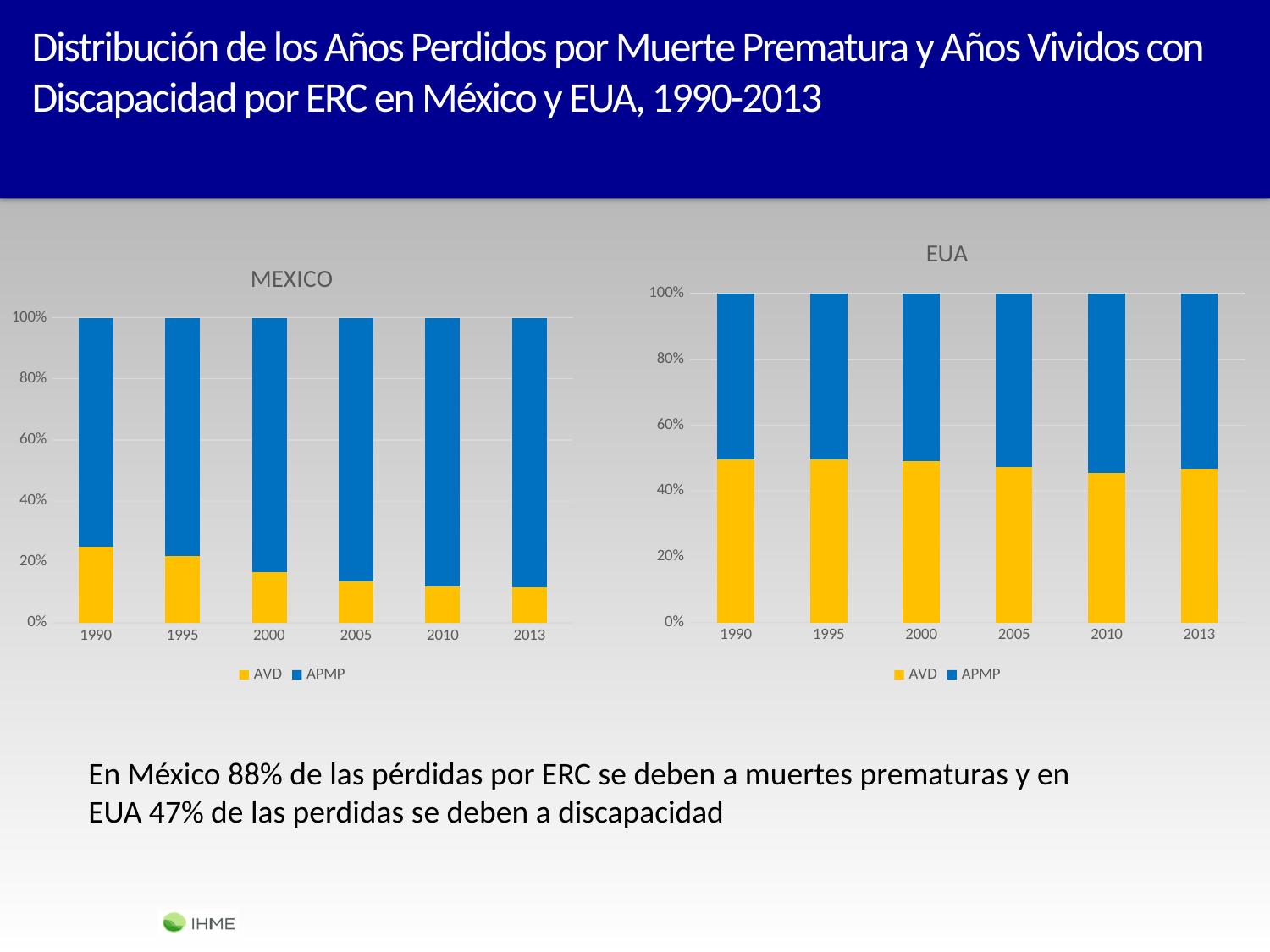
How many years are shown on the x axis of the EUA chart? 6 How many series does the legend of the MEXICO chart list? 2 In the MEXICO chart, is the AVD value for 2013 greater or less than 20%? less In the EUA chart, is the AVD value for 1990 greater or less than 40%? greater In the MEXICO chart, does the AVD share rise or fall from 1990 to 2013? fall What kind of chart is the MEXICO chart? stacked bar chart In the MEXICO chart, which is larger, the AVD value for 1990 or the AVD value for 2005? 1990 Which is larger, the AVD value for 1990 in the EUA chart or the AVD value for 1990 in the MEXICO chart? EUA In the EUA chart, is the APMP value for 2005 greater or less than 40%? greater Which series is shown in yellow in the EUA chart? AVD In the MEXICO chart, which year has the highest AVD share? 1990